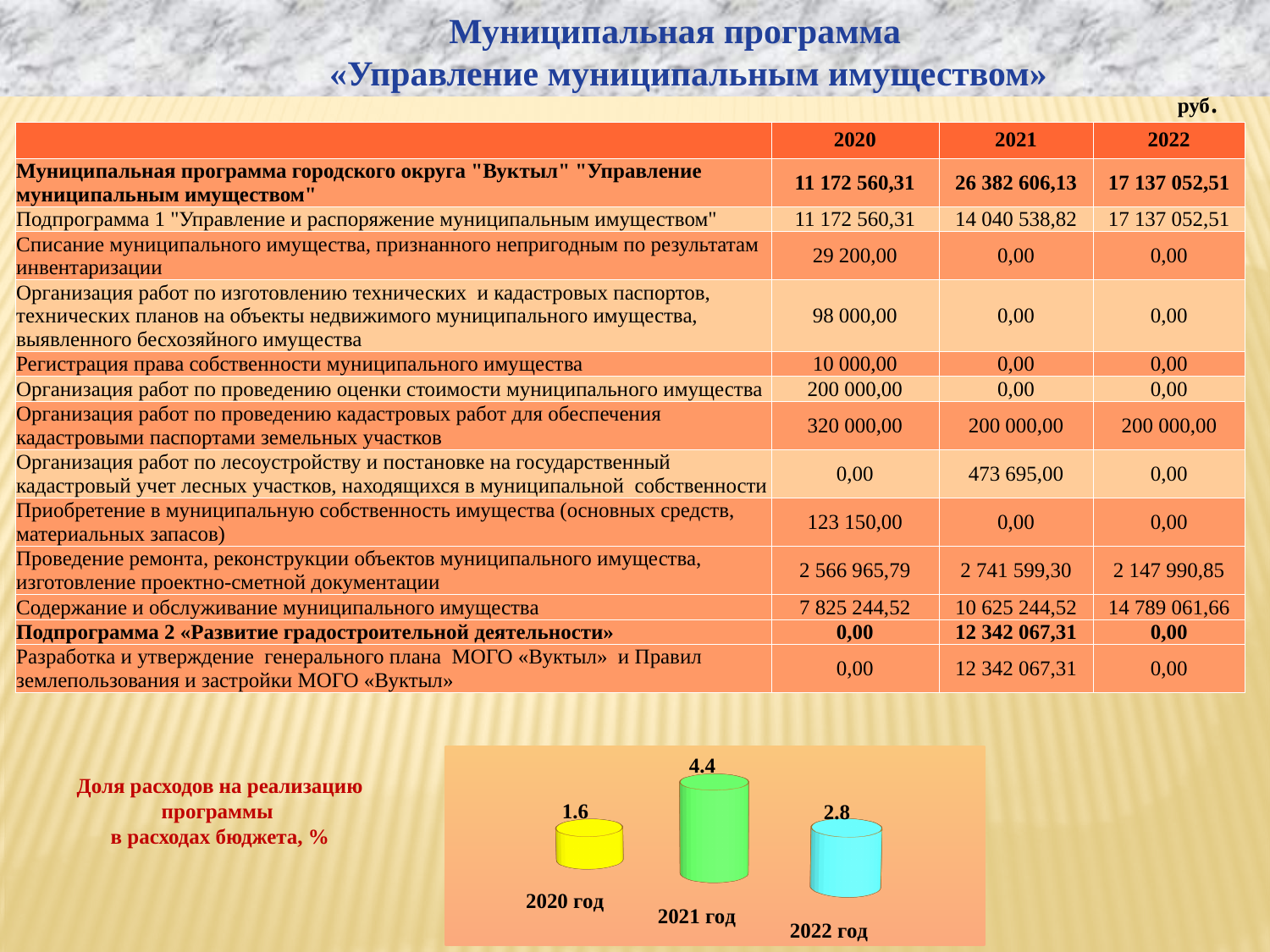
How many years (bars) are shown in the chart at the bottom of the slide? 3 What kind of chart is shown at the bottom of the slide? bar chart What is the value for 2021 год in the chart of the share of programme expenditure in the budget? 4.4 In the chart, does the value rise or fall from 2021 год to 2022 год? fall In the chart, which is larger: the value for 2022 год or the value for 2020 год? 2022 год In the chart, what is the difference between the values for 2021 год and 2022 год? 1.6 In the chart, what is the difference between the values for 2021 год and 2020 год? 2.8 What is the value for 2020 год in the chart of the share of programme expenditure in the budget? 1.6 Which year has the lowest share of programme expenditure in the budget in the chart? 2020 год Which year has the highest share of programme expenditure in the budget in the chart? 2021 год What is the value for 2022 год in the chart of the share of programme expenditure in the budget? 2.8 What colour is the bar for 2021 год in the chart? green